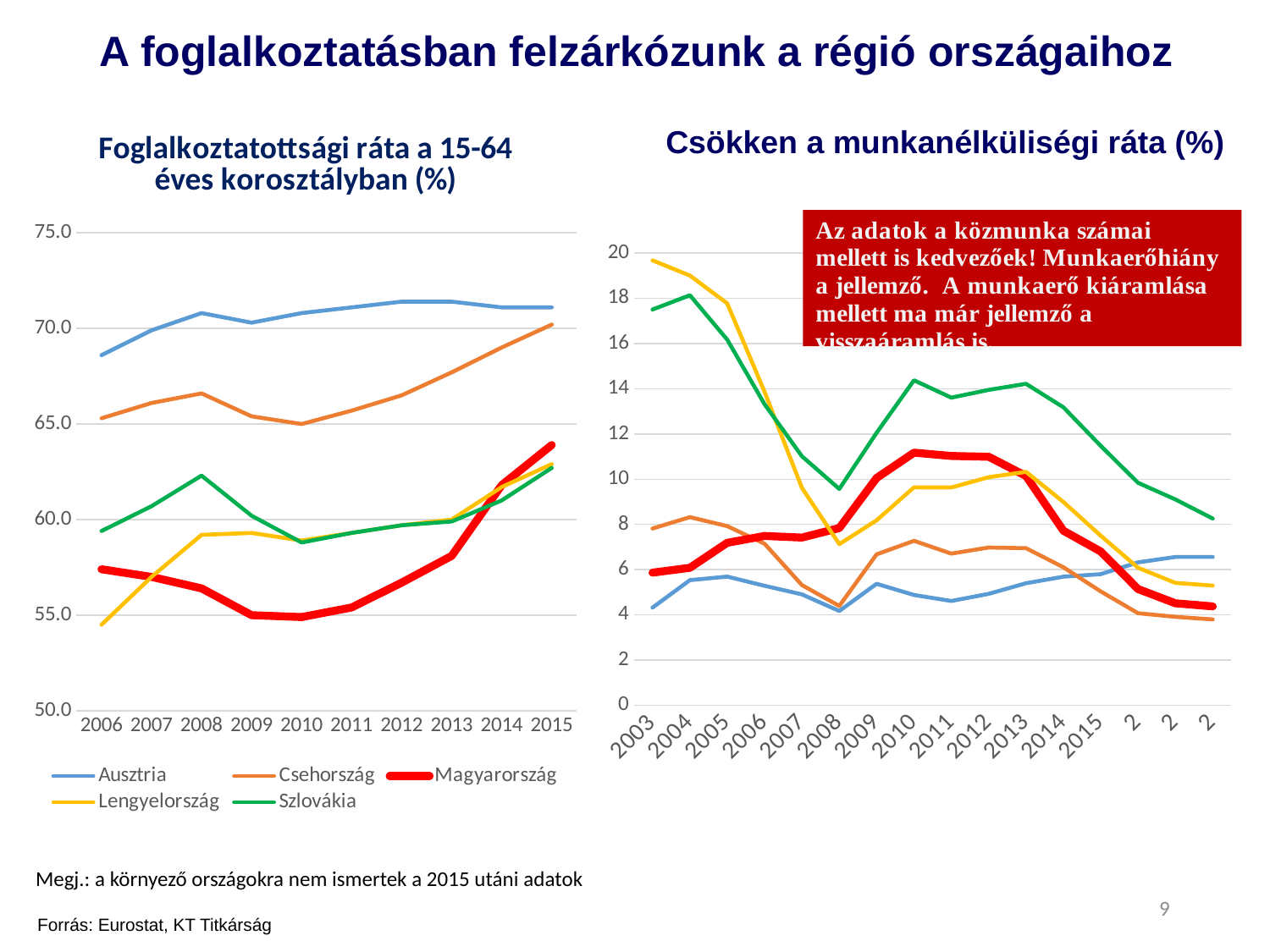
In the left chart, 'Foglalkoztatottsági ráta a 15-64 éves korosztályban (%)', which country has the lowest employment rate in 2010? Magyarország What kind of chart is the left chart, 'Foglalkoztatottsági ráta a 15-64 éves korosztályban (%)'? Line chart What is the title of the right chart on the slide? Csökken a munkanélküliségi ráta (%) In the left chart, 'Foglalkoztatottsági ráta a 15-64 éves korosztályban (%)', does the value for Magyarország rise or fall from 2010 to 2015? Rise In the left chart, 'Foglalkoztatottsági ráta a 15-64 éves korosztályban (%)', is the value for Ausztria in 2015 greater or less than 70.0? greater In the left chart, 'Foglalkoztatottsági ráta a 15-64 éves korosztályban (%)', is the value for Ausztria in 2006 greater or less than 70.0? less How many series does the legend of the left chart, 'Foglalkoztatottsági ráta a 15-64 éves korosztályban (%)', list? 5 In the left chart, 'Foglalkoztatottsági ráta a 15-64 éves korosztályban (%)', is the value for Magyarország in 2015 greater or less than 60.0? greater In the left chart, 'Foglalkoztatottsági ráta a 15-64 éves korosztályban (%)', which country has the lowest employment rate in 2006? Lengyelország How many years are shown on the x axis of the left chart, 'Foglalkoztatottsági ráta a 15-64 éves korosztályban (%)'? 10 In the left chart, 'Foglalkoztatottsági ráta a 15-64 éves korosztályban (%)', which is larger in 2012: the value for Csehország or the value for Szlovákia? Csehország In the left chart, 'Foglalkoztatottsági ráta a 15-64 éves korosztályban (%)', which country has the highest employment rate in 2015? Ausztria